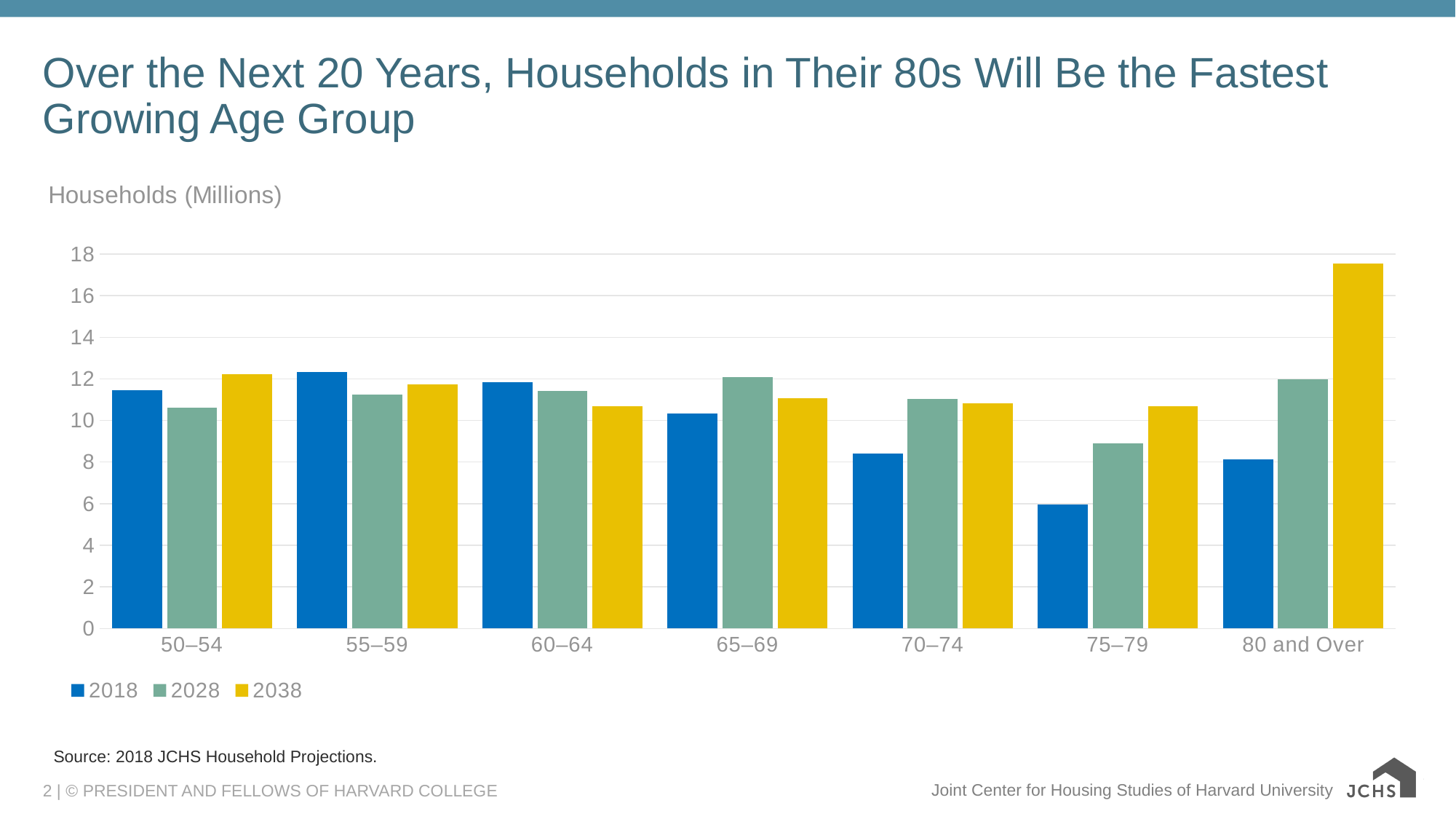
Is the 2028 value for 65–69 greater or less than 10? greater Which age group has the lowest 2018 value? 75–79 For the 50–54 age group, which is larger: the 2018 value or the 2028 value? 2018 How many age group categories are shown on the x axis? 7 For the 75–79 age group, which is larger: the 2018 value or the 2038 value? 2038 What is the label on the vertical axis of the chart? Households (Millions) How many series does the legend list? 3 Does the 2018 series rise or fall from 55–59 to 75–79? fall Is the 2038 value for 80 and Over greater or less than 16? greater Which age group and year has the tallest bar in the chart? 80 and Over, 2038 Is the 2018 value for 75–79 greater or less than 8? less What kind of chart is shown on the slide? bar chart